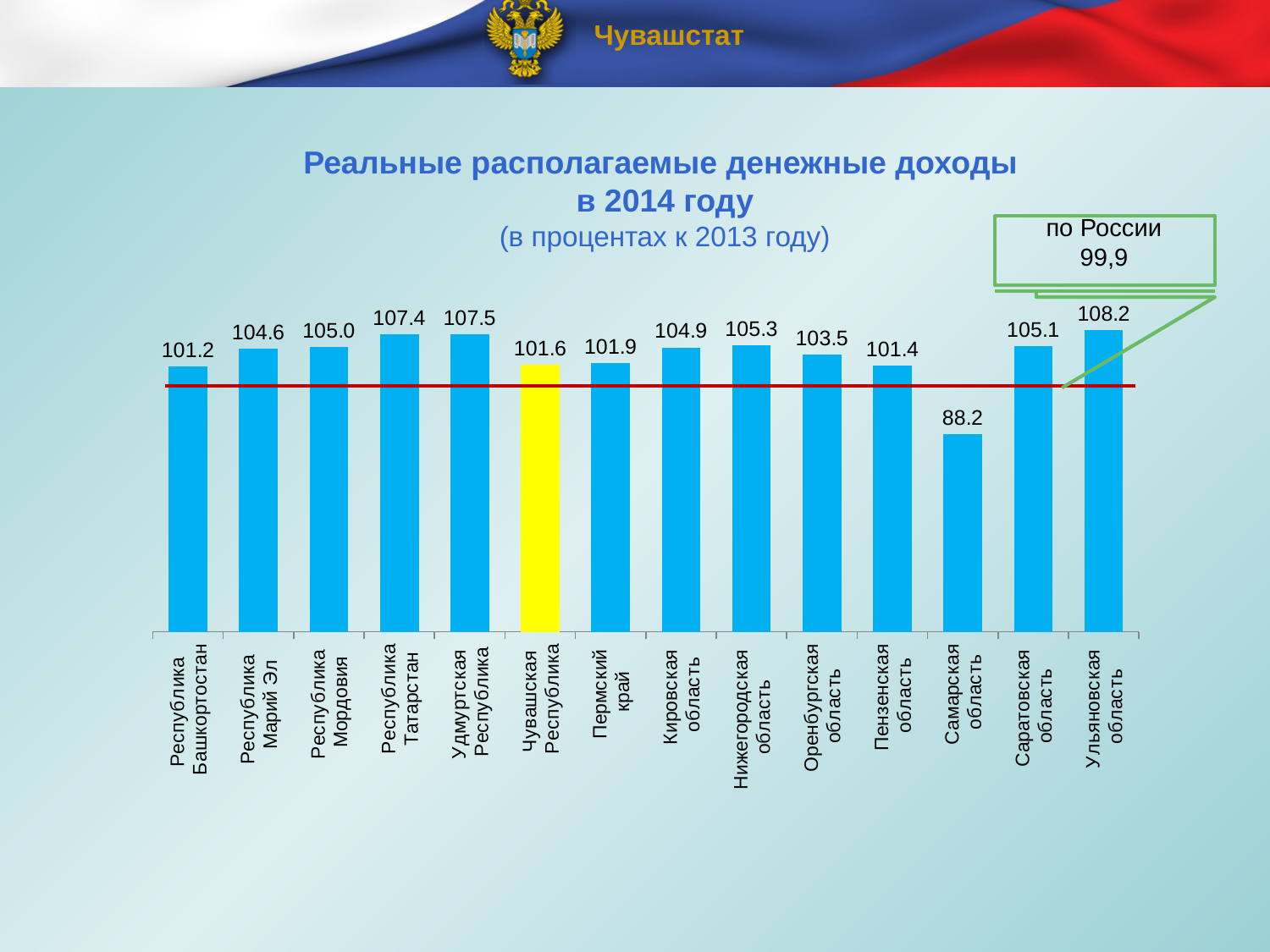
What is the value for Самарская область? 88.2 Which region's bar is highlighted in yellow? Чувашская Республика What is the difference between the values for Ульяновская область and Самарская область? 20.0 What is the value for Республика Татарстан? 107.4 How many regions are shown on the chart? 14 What is the difference between the values for Удмуртская Республика and Чувашская Республика? 5.9 What is the value for Чувашская Республика? 101.6 Which is larger, the value for Кировская область or the value for Оренбургская область? Кировская область What kind of chart is shown on the slide? Bar chart What value for Russia as a whole (по России) is shown in the callout box? 99,9 Which region has the lowest value on the chart? Самарская область Which region has the highest value on the chart? Ульяновская область